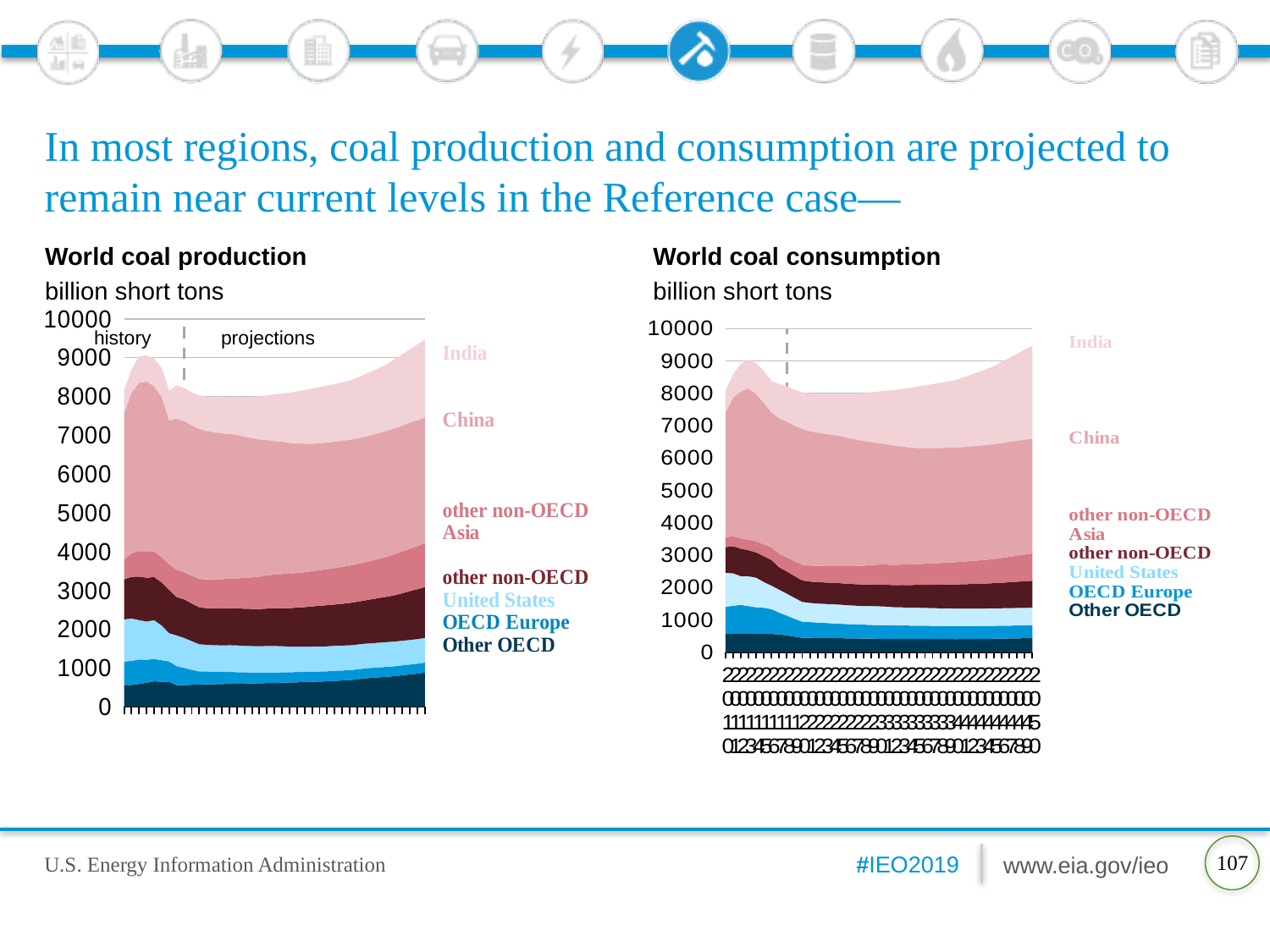
What unit is used on the y axis of the World coal production chart? billion short tons What kind of chart is the World coal production chart? stacked area chart Which series is at the top of the stack in the World coal consumption chart? India How many series does the legend of the World coal production chart list? 7 How many series does the legend of the World coal consumption chart list? 7 In the World coal consumption chart, is the value for Other OECD at the right end of the chart greater or less than 1000? less In the World coal consumption chart, is the total consumption at the right end of the chart greater or less than 9000? greater In the World coal production chart, is the total production at the right end of the chart greater or less than 9000? greater In the World coal production chart, does total production rise or fall over the projections period? rise In the World coal consumption chart, does total consumption rise or fall over the second half of the chart? rise What kind of chart is the World coal consumption chart? stacked area chart